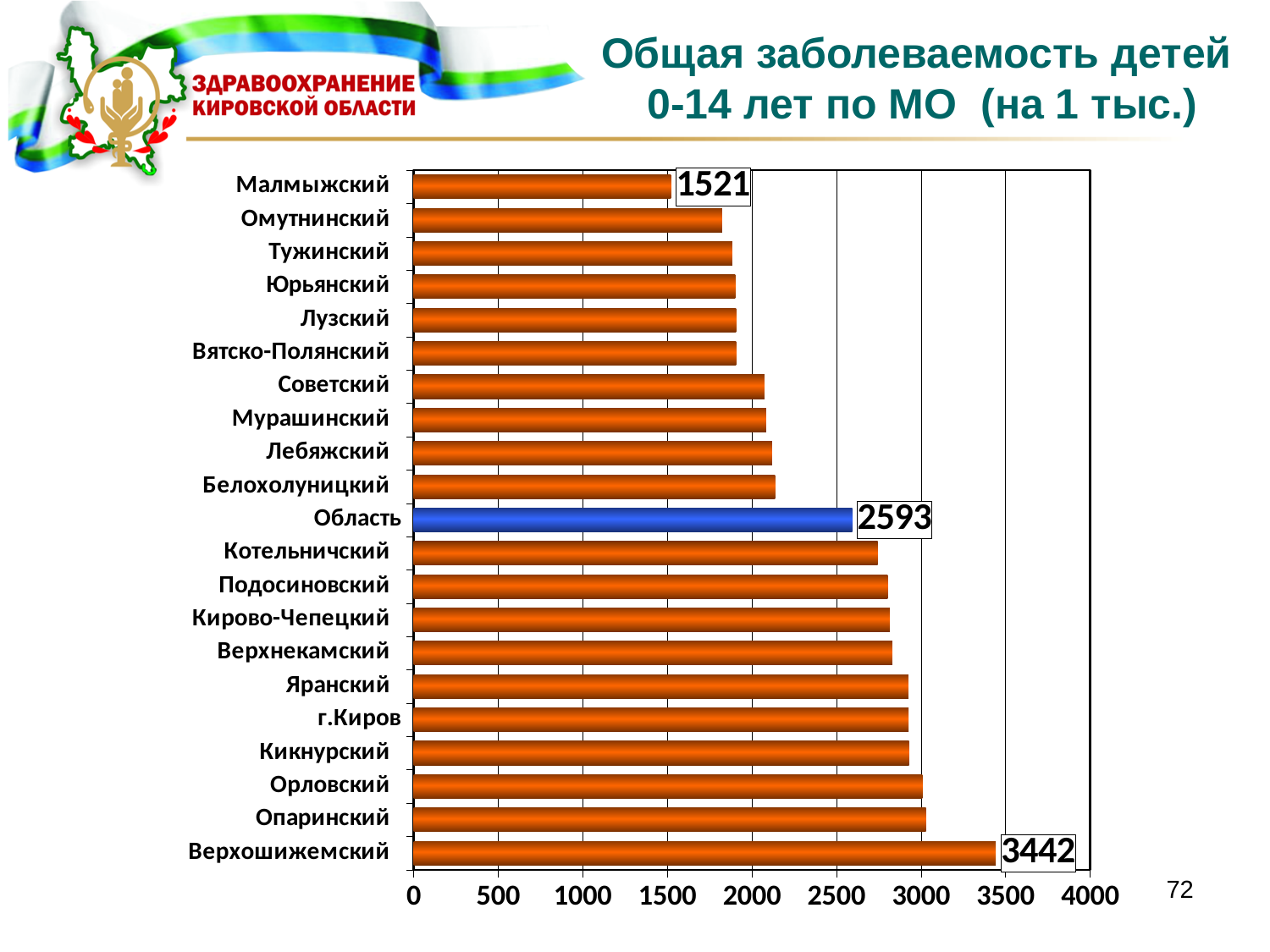
Which category has the lowest value? Малмыжский What is the difference between the values for Верхошижемский and Область? 849 What type of chart is shown on the slide? bar chart What is the value for Верхошижемский? 3442 What colour is the bar for Область? blue How many categories are plotted on the chart? 21 Is the value for Котельничский greater or less than 2500? greater Is the value for Омутнинский greater or less than 2000? less What is the value for Малмыжский? 1521 What is the value for Область? 2593 Which category has the highest value? Верхошижемский What is the difference between the values for Верхошижемский and Малмыжский? 1921